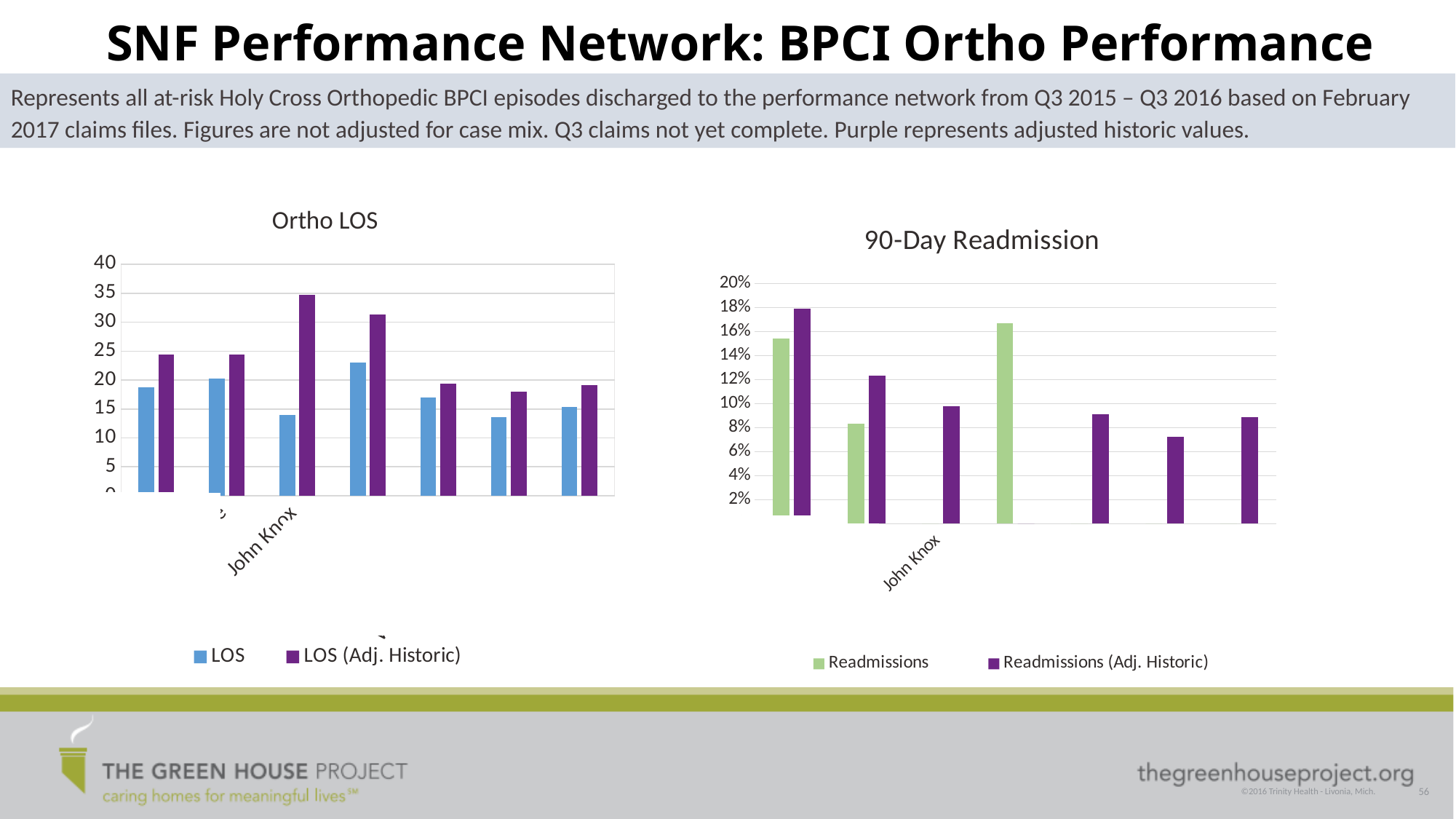
In the 90-Day Readmission chart, which is larger for John Knox: Readmissions or Readmissions (Adj. Historic)? Readmissions (Adj. Historic) In the Ortho LOS chart, is the LOS (Adj. Historic) value for John Knox greater or less than 20? greater What kind of chart is the 90-Day Readmission chart? bar chart How many categories are plotted in the 90-Day Readmission chart? 7 How many series does the legend of the Ortho LOS chart list? 2 In the Ortho LOS chart, which is larger for John Knox: LOS or LOS (Adj. Historic)? LOS (Adj. Historic) In the 90-Day Readmission chart, is the Readmissions value for John Knox greater or less than 10%? less What kind of chart is the Ortho LOS chart? bar chart In the Ortho LOS chart, is the LOS value for John Knox greater or less than 15? less How many categories are plotted in the Ortho LOS chart? 7 In the 90-Day Readmission chart, what series do the purple bars represent? Readmissions (Adj. Historic) How many series does the legend of the 90-Day Readmission chart list? 2